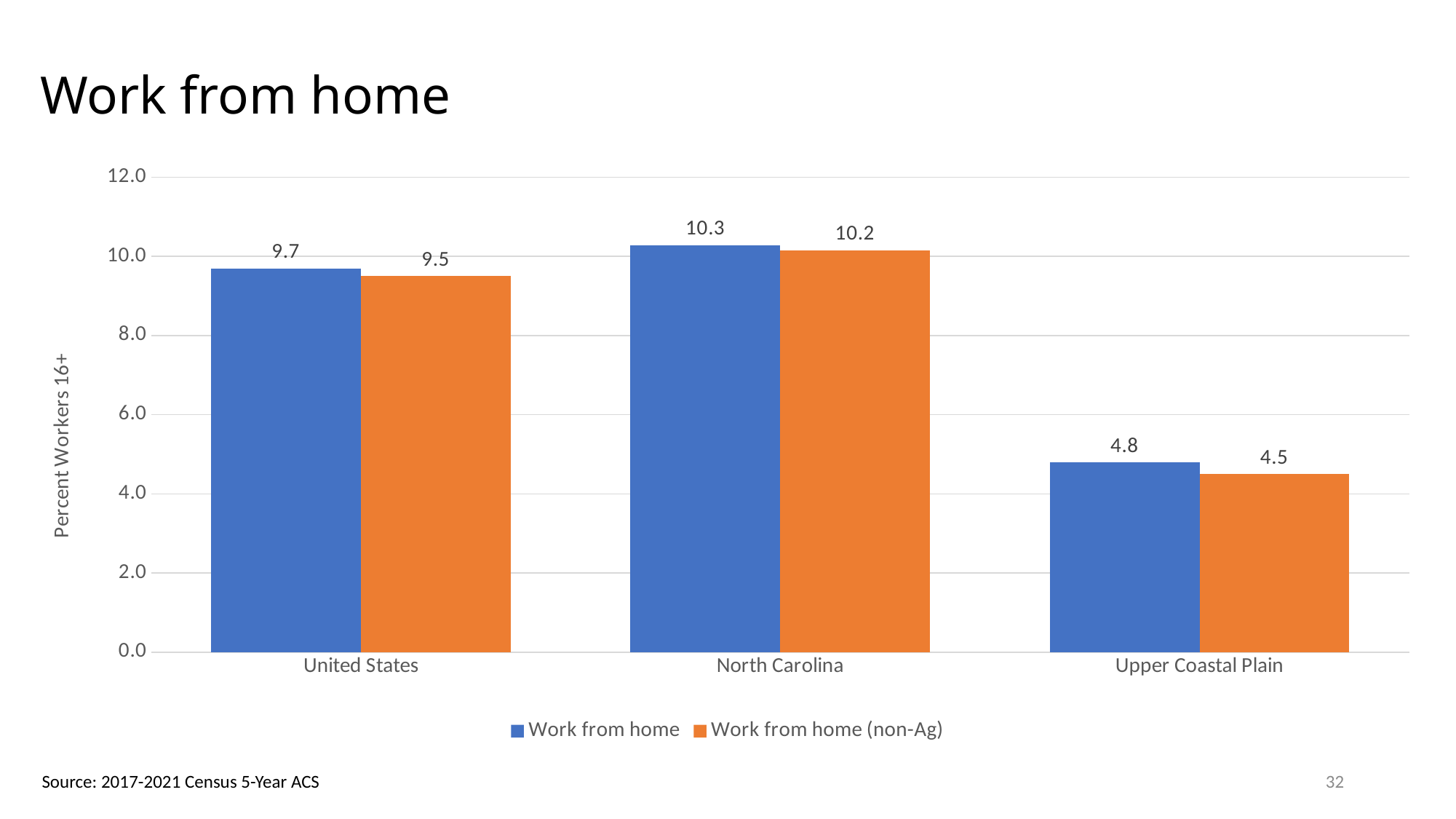
Is the Work from home (non-Ag) value for Upper Coastal Plain greater or less than 6.0? less How many categories are shown on the x axis? 3 What is the Work from home value for United States? 9.7 Which is larger: the Work from home value for United States or for Upper Coastal Plain? United States What kind of chart is shown on the slide? bar chart What is the Work from home (non-Ag) value for Upper Coastal Plain? 4.5 What is the difference between the Work from home and Work from home (non-Ag) values for United States? 0.2 What is the difference between the Work from home values for North Carolina and Upper Coastal Plain? 5.5 Which category has the lowest Work from home (non-Ag) value? Upper Coastal Plain How many series does the legend list? 2 What is the Work from home value for North Carolina? 10.3 Which category has the highest Work from home value? North Carolina